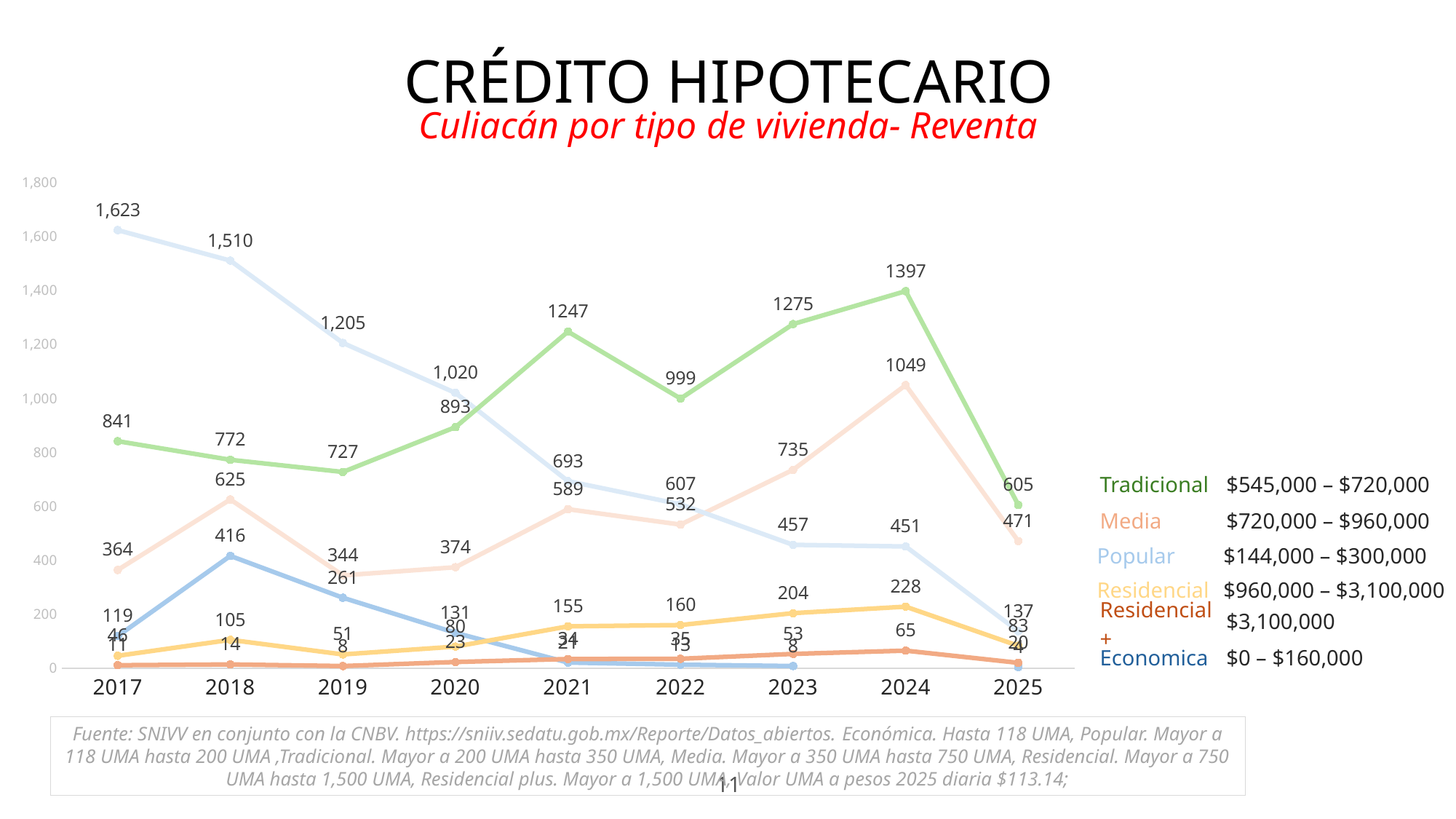
In 2021, which is larger: Tradicional or Popular? Tradicional In which year does the Tradicional series have its lowest value? 2025 What kind of chart is shown on the slide? line chart How many years are shown on the x axis? 9 Does the Popular series rise or fall from 2017 to 2025? fall What is the value for Residencial in 2024? 228 How many series does the legend list? 6 What is the value for Popular in 2017? 1,623 What is the value for Media in 2024? 1049 What is the value for Tradicional in 2024? 1397 What is the difference between the Tradicional values in 2024 and 2025? 792 In which year does the Tradicional series reach its highest value? 2024